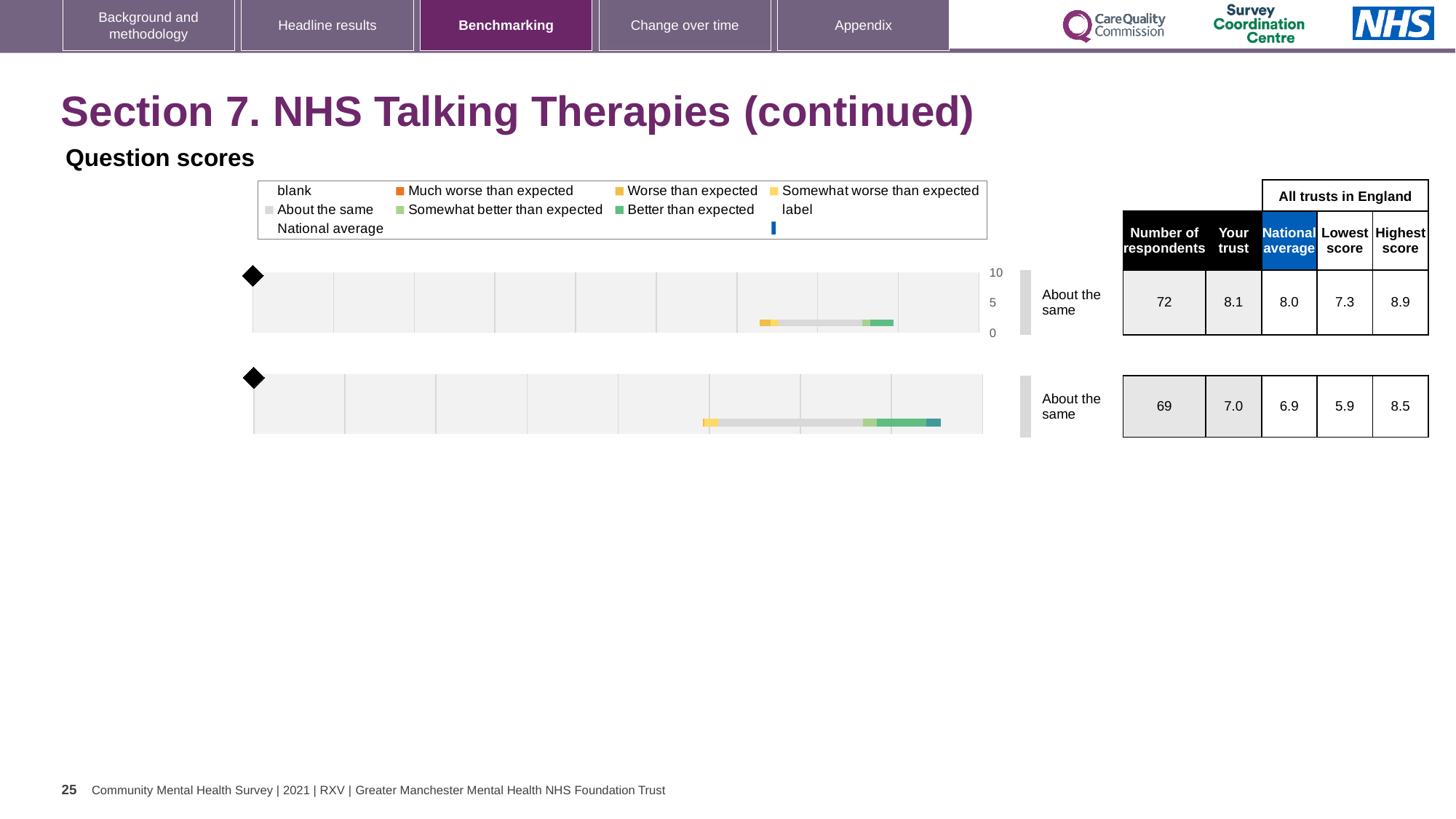
What benchmark category is given for the bottom chart? About the same For the top chart, how many respondents are shown in the table? 72 For the bottom chart, what is the difference between the highest score and the lowest score among all trusts in England? 2.6 For the top chart, what is the highest score among all trusts in England? 8.9 How many question score charts are shown on the slide? 2 For the top chart, what is the 'Your trust' score shown in the table? 8.1 For the top chart, what is the difference between the 'Your trust' score and the national average? 0.1 Which chart has more respondents, the top chart or the bottom chart? The top chart For the bottom chart, what is the lowest score among all trusts in England? 5.9 For the top chart, what is the national average score shown in the table? 8.0 What kind of chart is used to show the question scores on this slide? Bar chart For the bottom chart, what is the 'Your trust' score shown in the table? 7.0